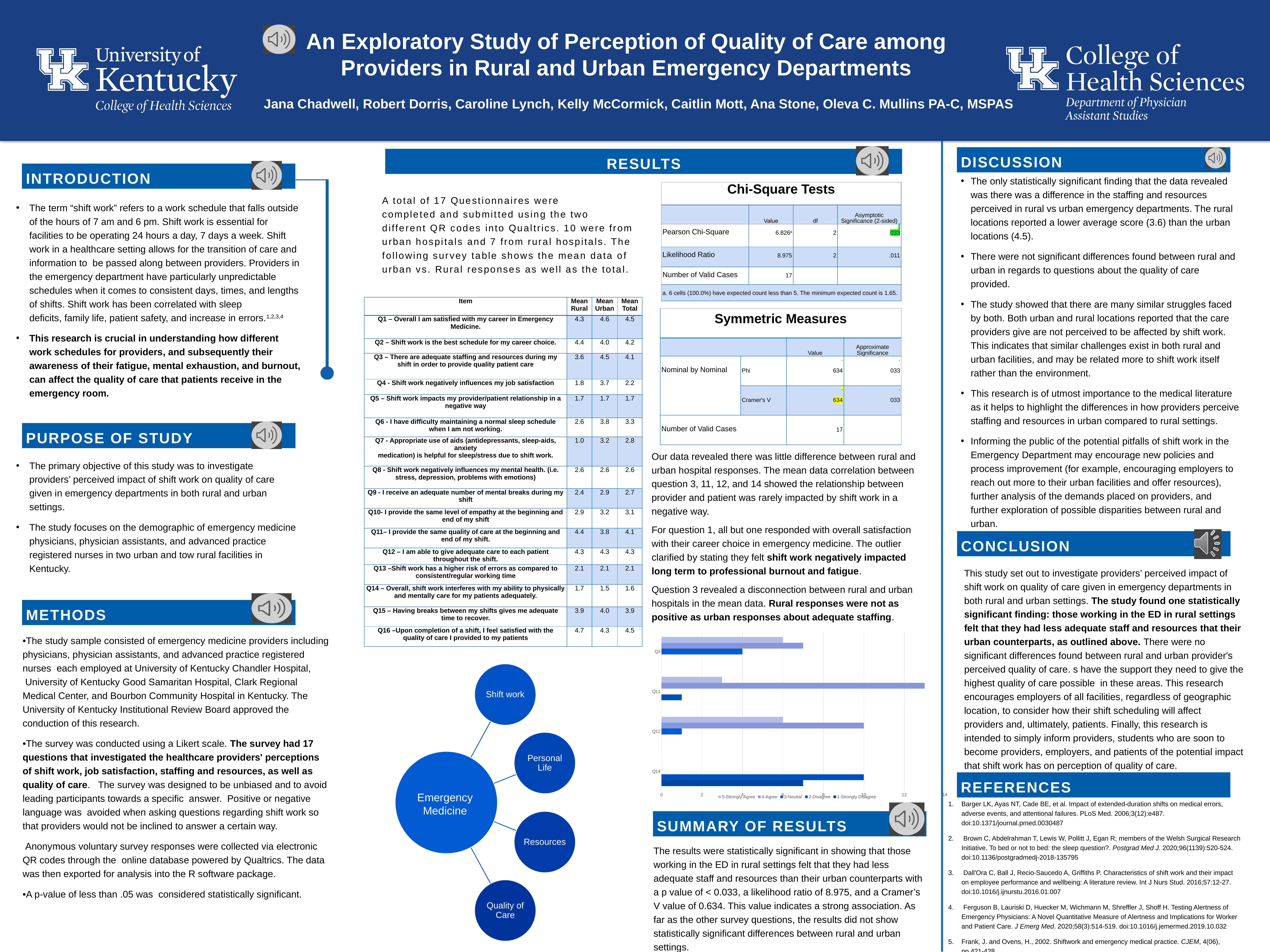
Which categories are shown on the vertical axis of the bar chart in the Results section? Q3, Q11, Q12, Q14 On the bar chart in the Results section, is the longest bar for Q14 greater or less than 8? greater On the bar chart in the Results section, is the longest bar for Q3 greater or less than 8? less On the bar chart in the Results section, is the longest bar for Q11 greater or less than 12? greater On the bar chart in the Results section, which has the longer longest bar, Q11 or Q3? Q11 What kind of chart is shown at the bottom of the Results section? bar chart On the bar chart in the Results section, which category has the single longest bar? Q11 How many categories (questions) are plotted on the bar chart in the Results section? 4 How many series does the legend of the bar chart in the Results section list? 5 What is the highest tick value shown on the horizontal axis of the bar chart in the Results section? 14